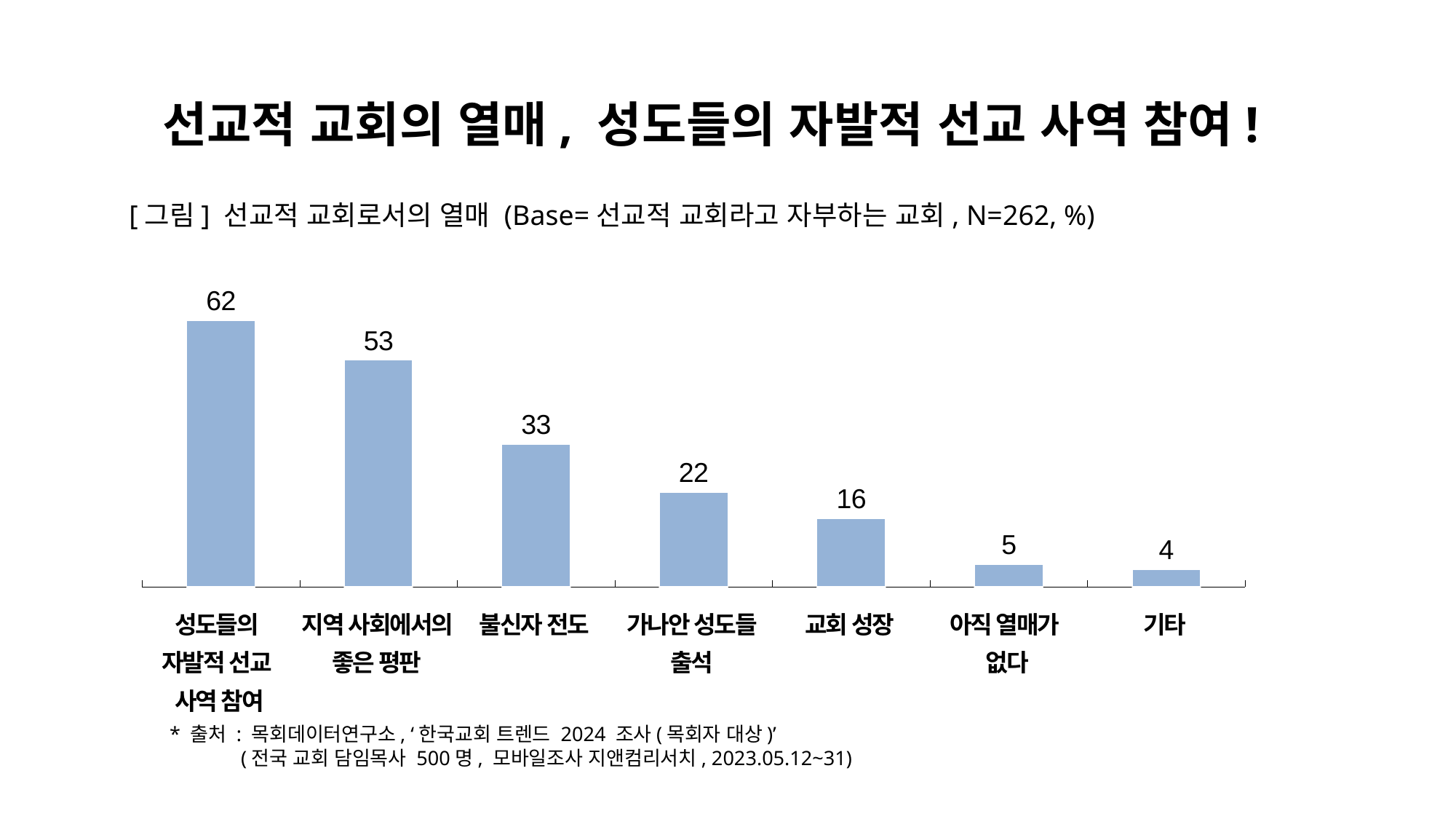
Which category has the highest value? 성도들의 자발적 선교 사역 참여 What is the value for 교회 성장? 16 What is the value for 성도들의 자발적 선교 사역 참여? 62 Which is larger, the value for 불신자 전도 or the value for 가나안 성도들 출석? 불신자 전도 Which category has the lowest value? 기타 How many categories are shown in the chart? 7 What kind of chart is shown on the slide? bar chart Do the values rise or fall from left to right along the x axis? fall What is the value for 지역 사회에서의 좋은 평판? 53 What is the difference between the values for 가나안 성도들 출석 and 교회 성장? 6 What is the difference between the values for 성도들의 자발적 선교 사역 참여 and 지역 사회에서의 좋은 평판? 9 What is the value for 불신자 전도? 33